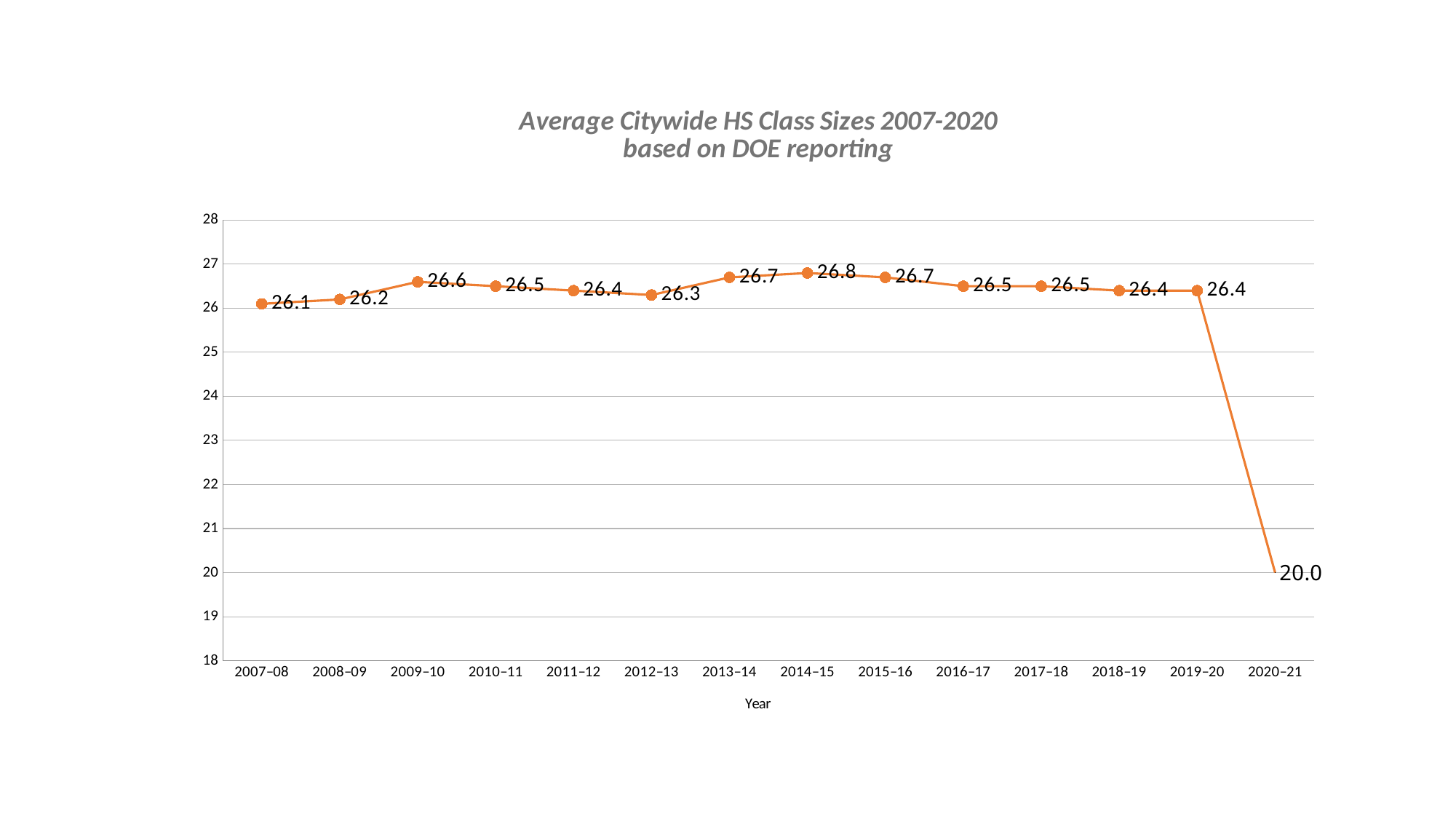
Does the average class size rise or fall from 2019–20 to 2020–21? fall How many years are plotted on the chart? 14 Which year has a larger average class size, 2009–10 or 2012–13? 2009–10 What is the difference between the average class size in 2019–20 and 2020–21? 6.4 Is the value for 2020–21 greater or less than 25? less What kind of chart is shown on the slide? line chart What is the average citywide HS class size for 2007–08? 26.1 What is the label of the x axis? Year Which year has the highest average class size? 2014–15 Which year has the lowest average class size? 2020–21 What is the average citywide HS class size for 2020–21? 20.0 What is the average citywide HS class size for 2014–15? 26.8